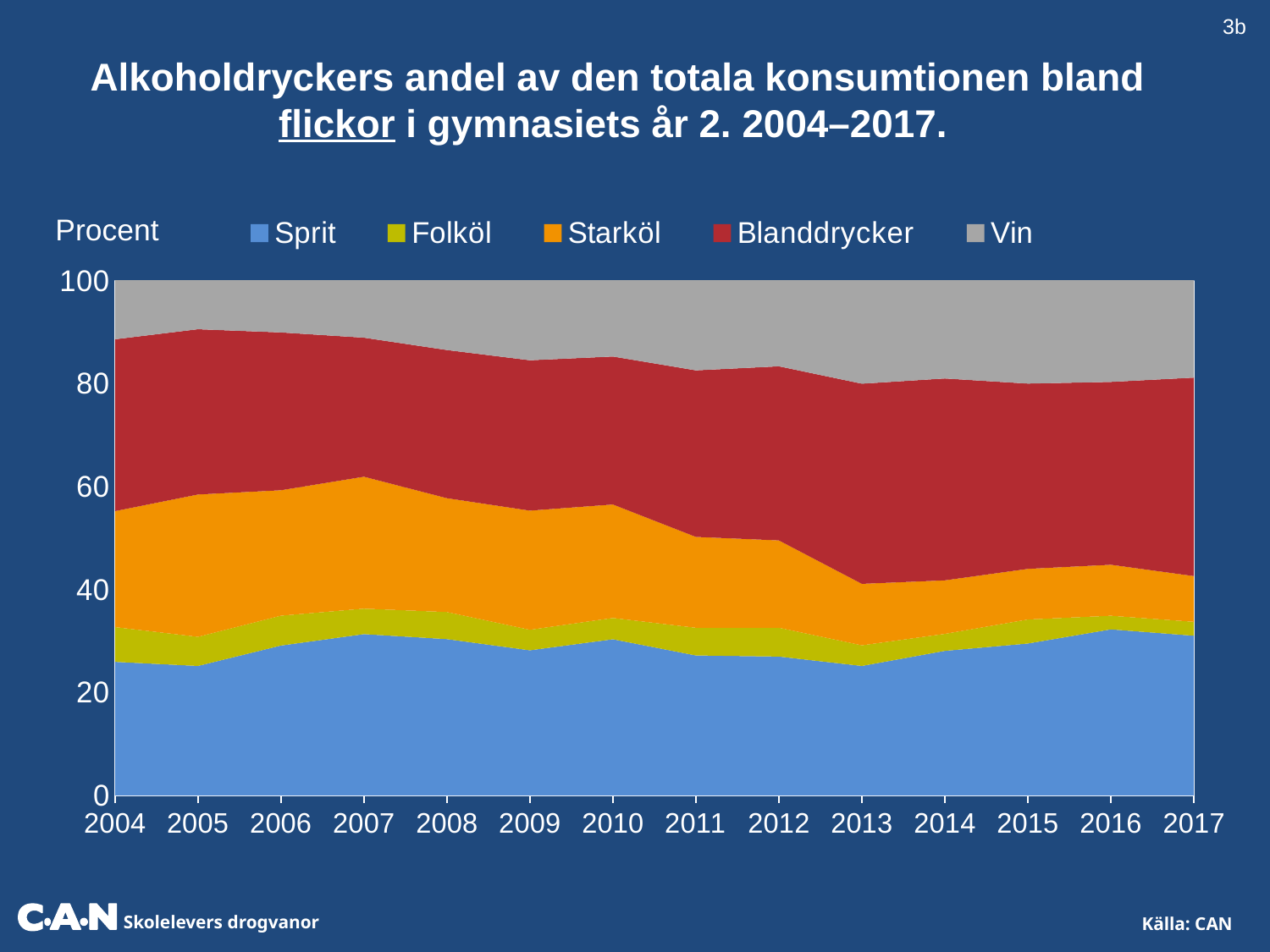
How many years are shown along the x axis? 14 What kind of chart is shown on the slide? Stacked area chart Is the cumulative top of the Sprit area in 2004 greater or less than 20? greater Which series has the smallest share in 2017? Folköl Is the share of Vin larger in 2004 or in 2017? 2017 How many series does the legend list? 5 Is the cumulative top of the Blanddrycker area in 2004 greater or less than 80? greater Is the cumulative top of the Starköl area in 2004 greater or less than 60? less Which series is listed first in the legend? Sprit What is the label on the y axis? Procent Which series has the largest share in 2017? Blanddrycker